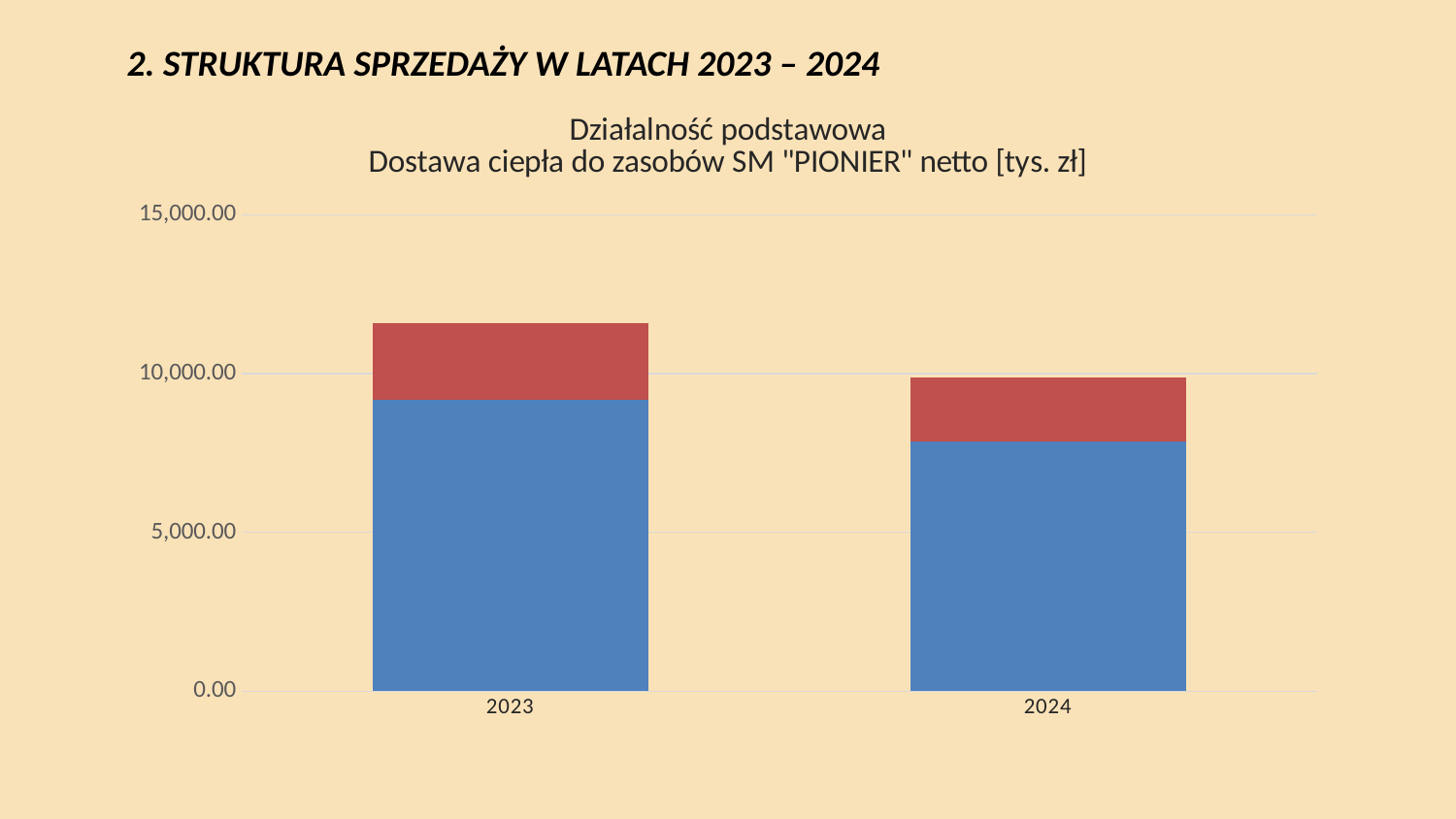
Is the total value of the bar for 2023 greater or less than 10,000.00? greater What kind of chart is shown on the slide? stacked bar chart Do the total bar values rise or fall from 2023 to 2024? fall How many years (categories) are shown on the x axis of the chart? 2 Is the blue segment of the 2024 bar greater or less than 5,000.00? greater Is the blue segment of the 2023 bar greater or less than 10,000.00? less Which year has the taller total bar, 2023 or 2024? 2023 What is the title of the chart? Działalność podstawowa Dostawa ciepła do zasobów SM "PIONIER" netto [tys. zł] Which year has the lowest total bar? 2024 Which year has the highest total bar? 2023 Is the blue segment larger in 2023 or in 2024? 2023